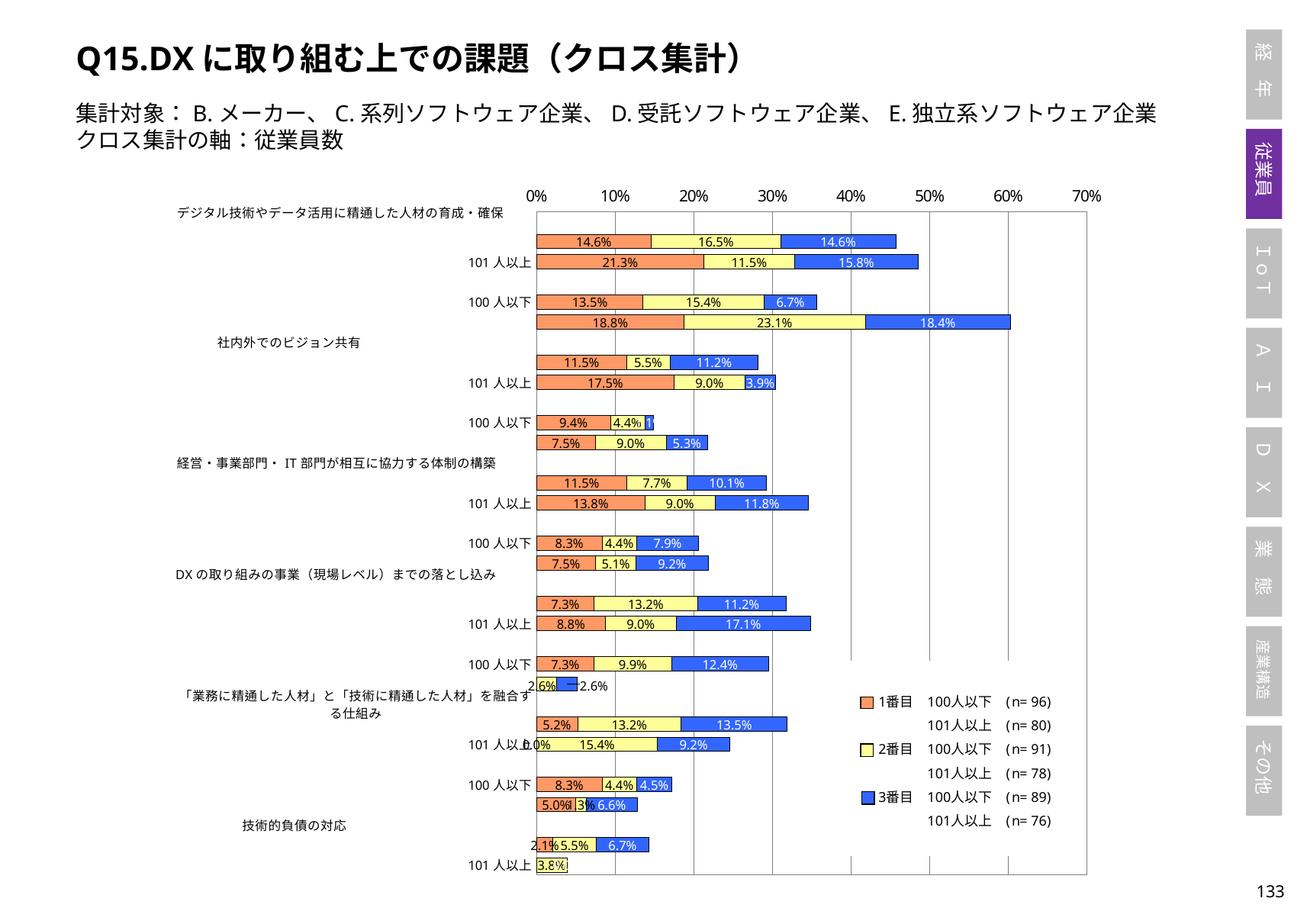
What is the total of the bar labeled 101 人以上 directly below the heading デジタル技術やデータ活用に精通した人材の育成・確保 (21.3%, 11.5%, 15.8%)? 48.6% In the topmost bar, which segment is larger, 1番目 or 2番目? 2番目 In the topmost bar (the first bar under the heading デジタル技術やデータ活用に精通した人材の育成・確保), what is the value of the 1番目 segment? 14.6% In the bar labeled 101 人以上 directly below the heading デジタル技術やデータ活用に精通した人材の育成・確保, what is the value of the 1番目 segment? 21.3% How many series does the legend list? 3 In the bar labeled 101 人以上 directly below the heading デジタル技術やデータ活用に精通した人材の育成・確保, what is the value of the 3番目 segment? 15.8% Does the topmost bar end at a value greater or less than 40%? greater What kind of chart is shown on the slide? bar chart What are the three series names in the legend? 1番目, 2番目, 3番目 According to the legend, what is the n for 1番目 100人以下? n= 96 What is the total of the topmost bar (14.6%, 16.5%, 14.6%)? 45.7% What is the largest single segment value printed on the chart? 23.1%